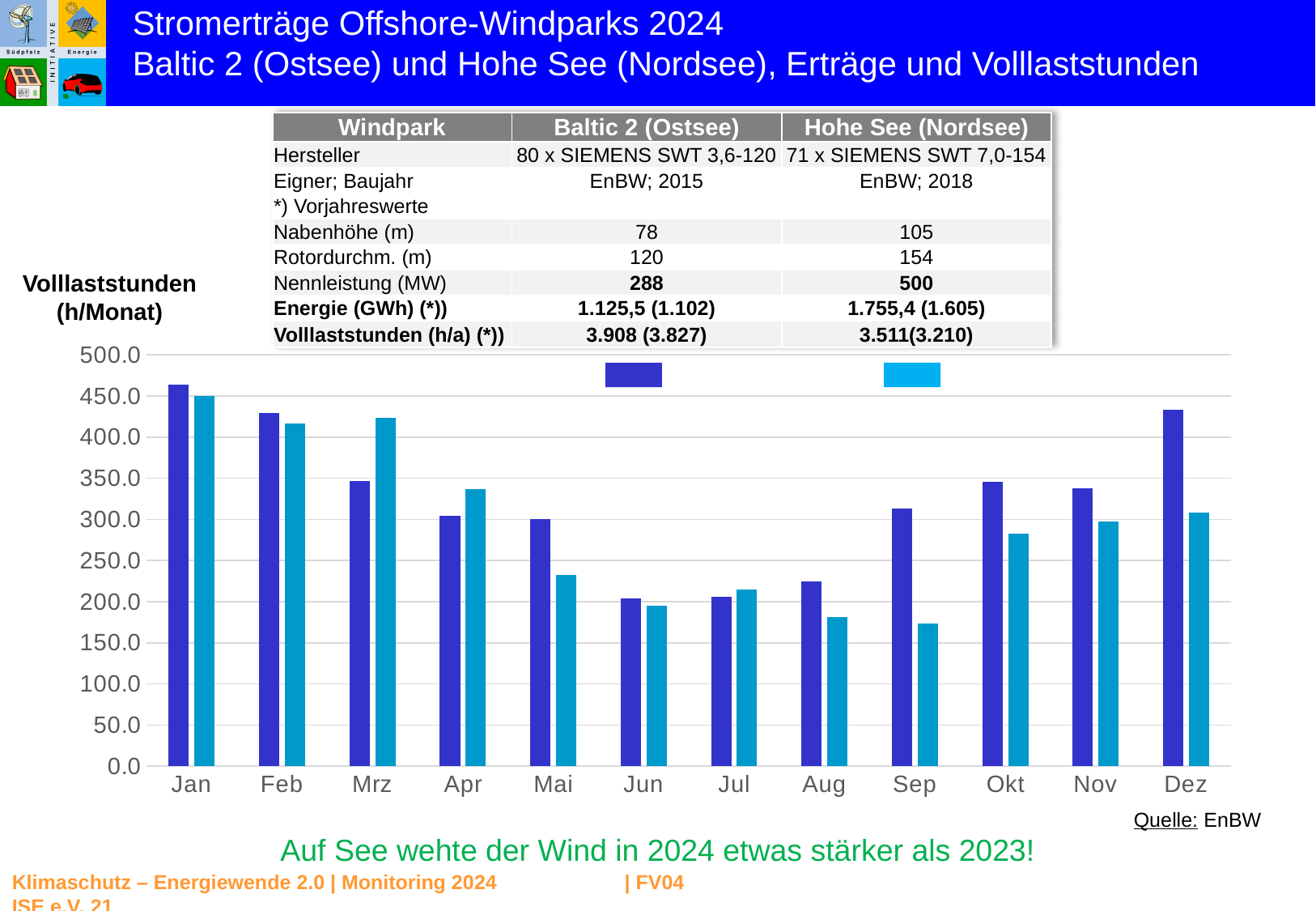
Is the dark blue value for Dez greater or less than 400? greater Is the light blue value for Mai greater or less than 250? less What kind of chart is shown on the slide? bar chart Do the dark blue values rise or fall from Jan to Jun? fall Is the dark blue value for Jan greater or less than 450? greater In Mrz, which series has the larger value, the dark blue or the light blue? light blue Which month has the highest value for the light blue series? Jan In Dez, which series has the larger value, the dark blue or the light blue? dark blue How many months are shown on the x axis of the chart? 12 Which month has the highest value for the dark blue series? Jan